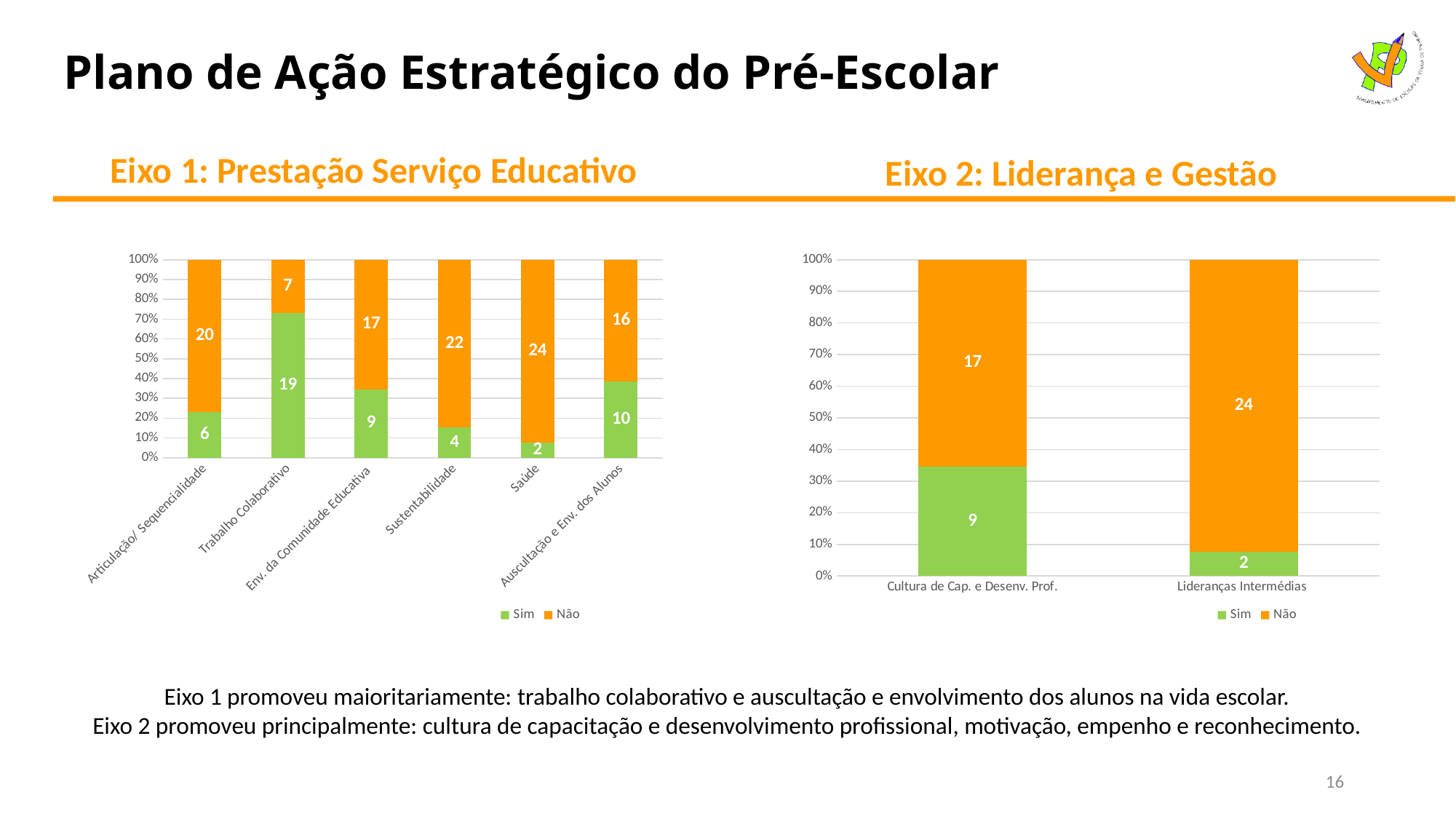
In the Eixo 2: Liderança e Gestão chart, what is the difference between the Não value and the Sim value for Cultura de Cap. e Desenv. Prof.? 8 In the Eixo 1: Prestação Serviço Educativo chart, what is the difference between the Não value for Sustentabilidade and the Não value for Trabalho Colaborativo? 15 In the Eixo 2: Liderança e Gestão chart, which category has the larger Sim value, Cultura de Cap. e Desenv. Prof. or Lideranças Intermédias? Cultura de Cap. e Desenv. Prof. What type of chart is the Eixo 2: Liderança e Gestão chart? Stacked bar chart In the Eixo 1: Prestação Serviço Educativo chart, which category has the highest Sim value? Trabalho Colaborativo In the Eixo 1: Prestação Serviço Educativo chart, how many categories are shown on the x axis? 6 In the Eixo 1: Prestação Serviço Educativo chart, what is the Sim value for Trabalho Colaborativo? 19 How many series does the legend of the Eixo 2: Liderança e Gestão chart list? 2 In the Eixo 1: Prestação Serviço Educativo chart, what is the Não value for Saúde? 24 In the Eixo 1: Prestação Serviço Educativo chart, which category has the lowest Sim value? Saúde In the Eixo 2: Liderança e Gestão chart, what is the Não value for Lideranças Intermédias? 24 In the Eixo 1: Prestação Serviço Educativo chart, what is the total of the stacked bar for Articulação/ Sequencialidade? 26